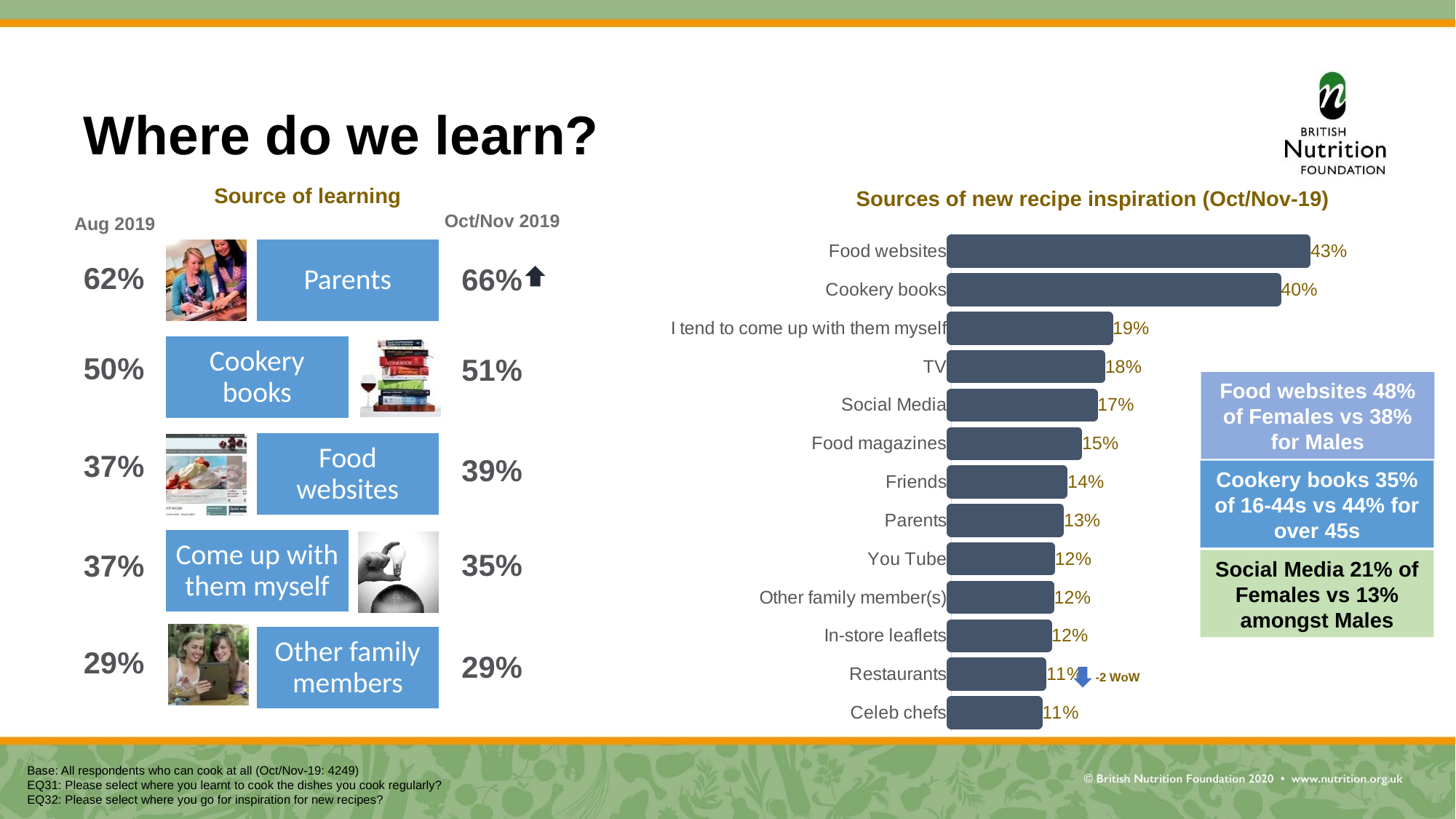
How many sources are listed in the 'Sources of new recipe inspiration (Oct/Nov-19)' chart? 13 In the 'Sources of new recipe inspiration (Oct/Nov-19)' chart, what is the difference between TV and Friends? 4% In the 'Sources of new recipe inspiration (Oct/Nov-19)' chart, what is the value for Parents? 13% In the 'Sources of new recipe inspiration (Oct/Nov-19)' chart, which source has the highest value? Food websites In the 'Sources of new recipe inspiration (Oct/Nov-19)' chart, what is the value for Food websites? 43% In the 'Sources of new recipe inspiration (Oct/Nov-19)' chart, what is the value for Celeb chefs? 11% In the 'Sources of new recipe inspiration (Oct/Nov-19)' chart, what is the value for I tend to come up with them myself? 19% In the 'Sources of new recipe inspiration (Oct/Nov-19)' chart, which is larger: Cookery books or TV? Cookery books In the 'Sources of new recipe inspiration (Oct/Nov-19)' chart, which is larger: Food magazines or Friends? Food magazines What kind of chart is 'Sources of new recipe inspiration (Oct/Nov-19)'? Bar chart In the 'Sources of new recipe inspiration (Oct/Nov-19)' chart, what is the value for Social Media? 17% In the 'Sources of new recipe inspiration (Oct/Nov-19)' chart, what is the difference between Food websites and Cookery books? 3%